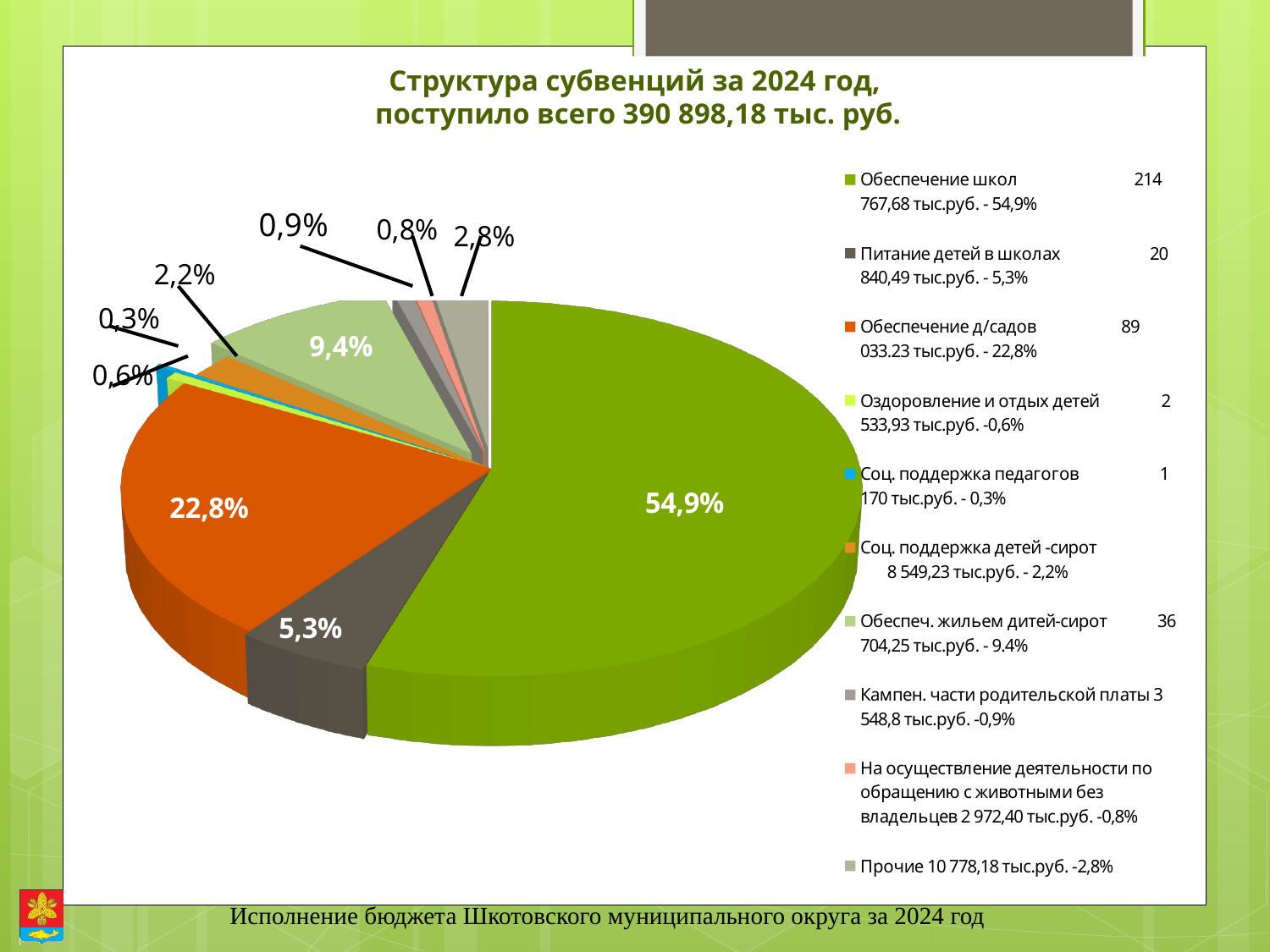
Which category has the smallest slice of the pie? Соц. поддержка педагогов What share of the pie does "Питание детей в школах" take? 5,3% What share of the pie does "Обеспечение школ" take? 54,9% What total amount of subventions is stated in the chart title? 390 898,18 тыс. руб. What share of the pie does "Обеспеч. жильем дитей-сирот" take? 9,4% Which category has the largest slice of the pie? Обеспечение школ What amount in тыс.руб. does the legend give for "Питание детей в школах"? 20 840,49 тыс.руб. How many categories does the legend list? 10 Which is larger, the share of "Прочие" or the share of "Соц. поддержка детей-сирот"? Прочие What is the difference in percentage points between the shares of "Обеспечение школ" and "Обеспечение д/садов"? 32,1 What kind of chart is shown on the slide? pie chart